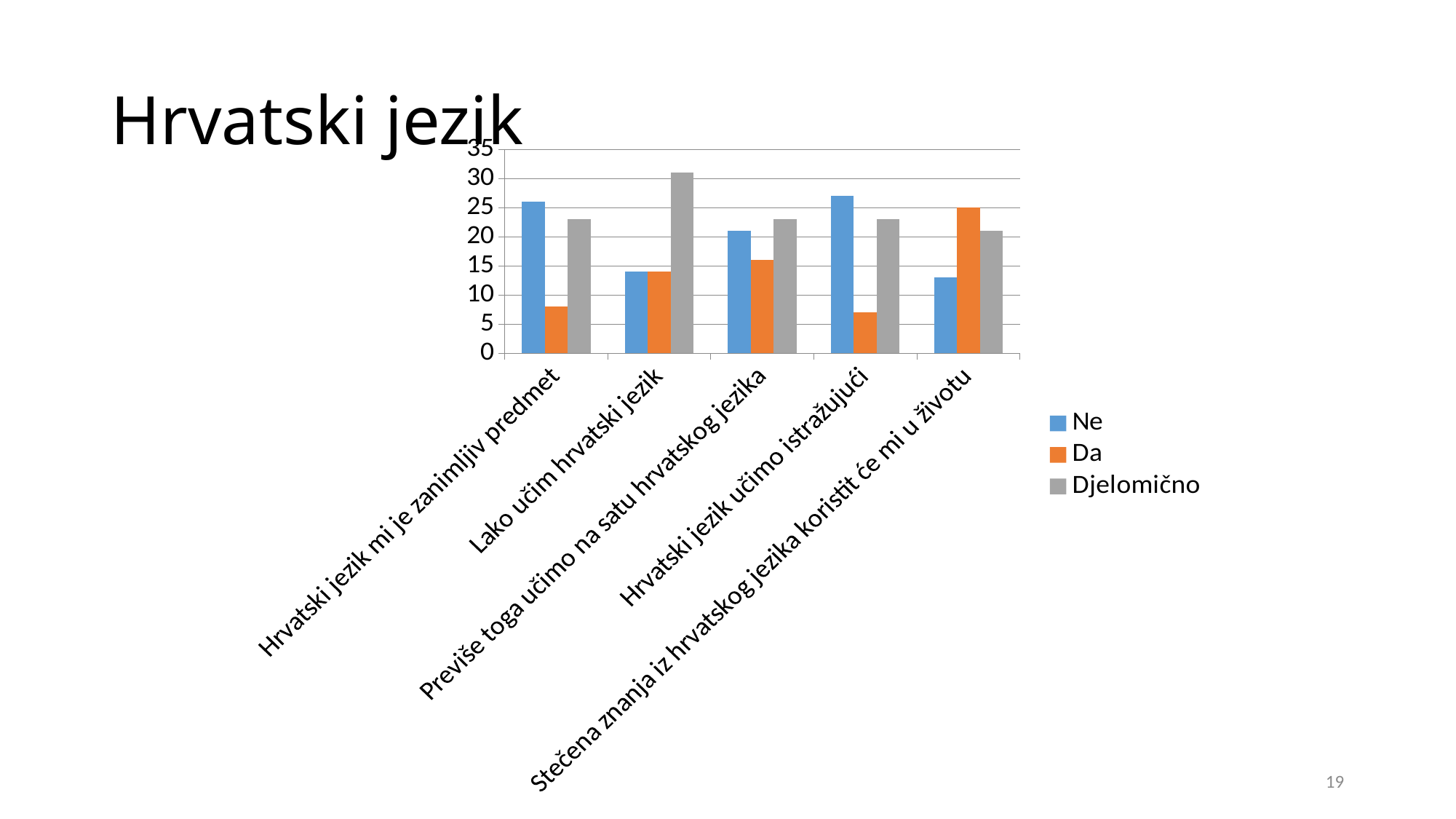
What is the title of the slide containing the chart? Hrvatski jezik Which series has the highest bar for "Lako učim hrvatski jezik"? Djelomično Which colour represents the "Da" series in the legend? orange Is the "Ne" value for "Hrvatski jezik učimo istražujući" greater or less than 25? greater Is the "Da" value for "Hrvatski jezik mi je zanimljiv predmet" greater or less than 10? less What kind of chart is shown on the slide? bar chart For "Hrvatski jezik mi je zanimljiv predmet", which is larger: the "Ne" value or the "Djelomično" value? Ne How many series does the legend list? 3 How many categories are shown on the x axis? 5 Which series has the lowest bar for "Hrvatski jezik učimo istražujući"? Da Is the "Djelomično" value for "Lako učim hrvatski jezik" greater or less than 30? greater For "Stečena znanja iz hrvatskog jezika koristit će mi u životu", which is larger: the "Ne" value or the "Da" value? Da